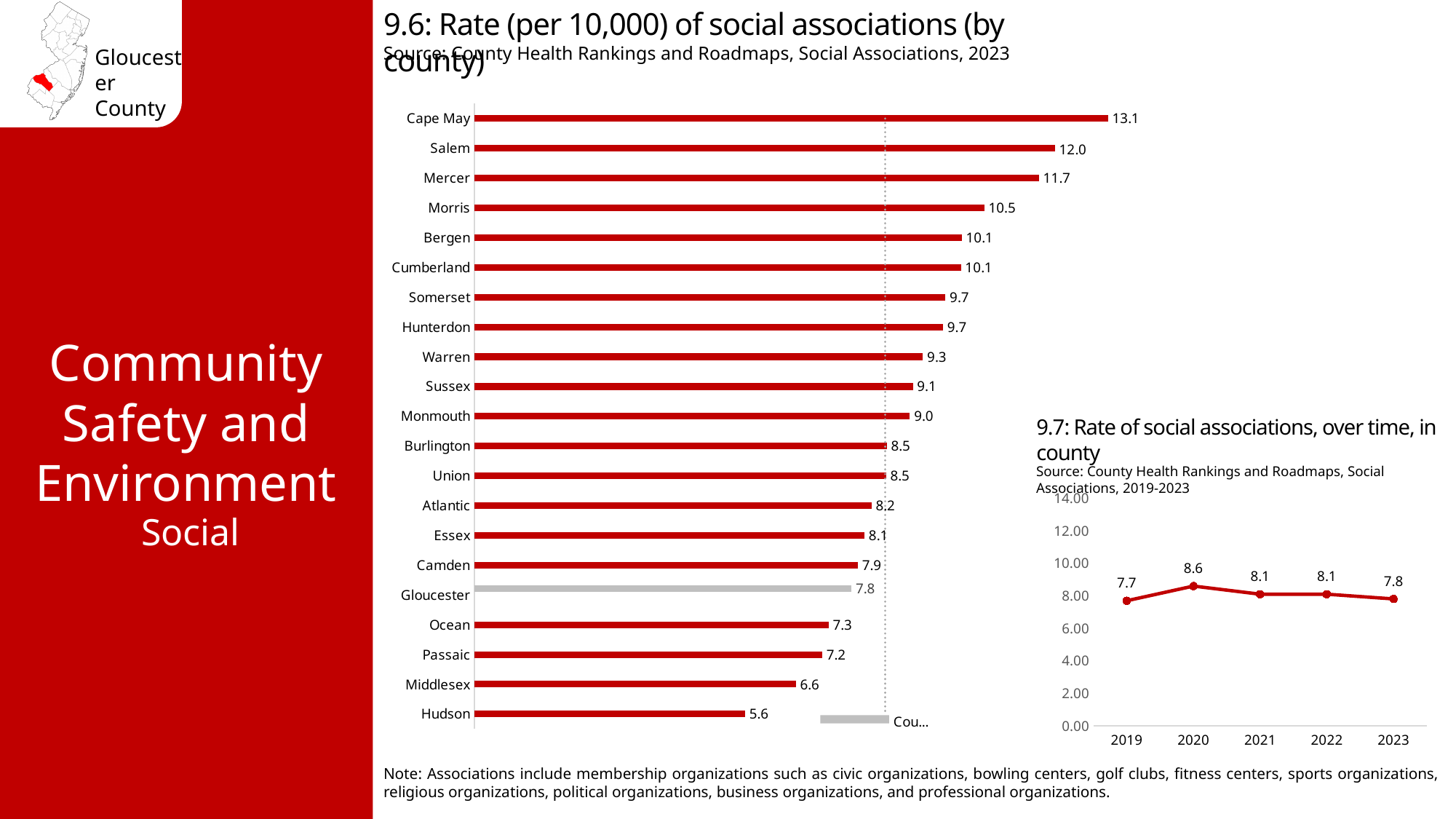
In the chart '9.6: Rate (per 10,000) of social associations (by county)', how many counties are shown? 21 In the chart '9.6: Rate (per 10,000) of social associations (by county)', which is larger, the value for Camden or the value for Ocean? Camden In the chart '9.6: Rate (per 10,000) of social associations (by county)', what is the difference between Cape May and Hudson? 7.5 In the chart '9.7: Rate of social associations, over time, in county', what is the difference between the 2020 and 2023 values? 0.8 In the chart '9.6: Rate (per 10,000) of social associations (by county)', which county has the highest rate? Cape May In the chart '9.6: Rate (per 10,000) of social associations (by county)', what is the value for Gloucester? 7.8 In the chart '9.7: Rate of social associations, over time, in county', which year has the lowest value? 2019 In the chart '9.6: Rate (per 10,000) of social associations (by county)', which county has the lowest rate? Hudson What kind of chart is '9.7: Rate of social associations, over time, in county'? Line chart What kind of chart is '9.6: Rate (per 10,000) of social associations (by county)'? Bar chart In the chart '9.7: Rate of social associations, over time, in county', what is the value for 2020? 8.6 In the chart '9.6: Rate (per 10,000) of social associations (by county)', what is the value for Mercer? 11.7